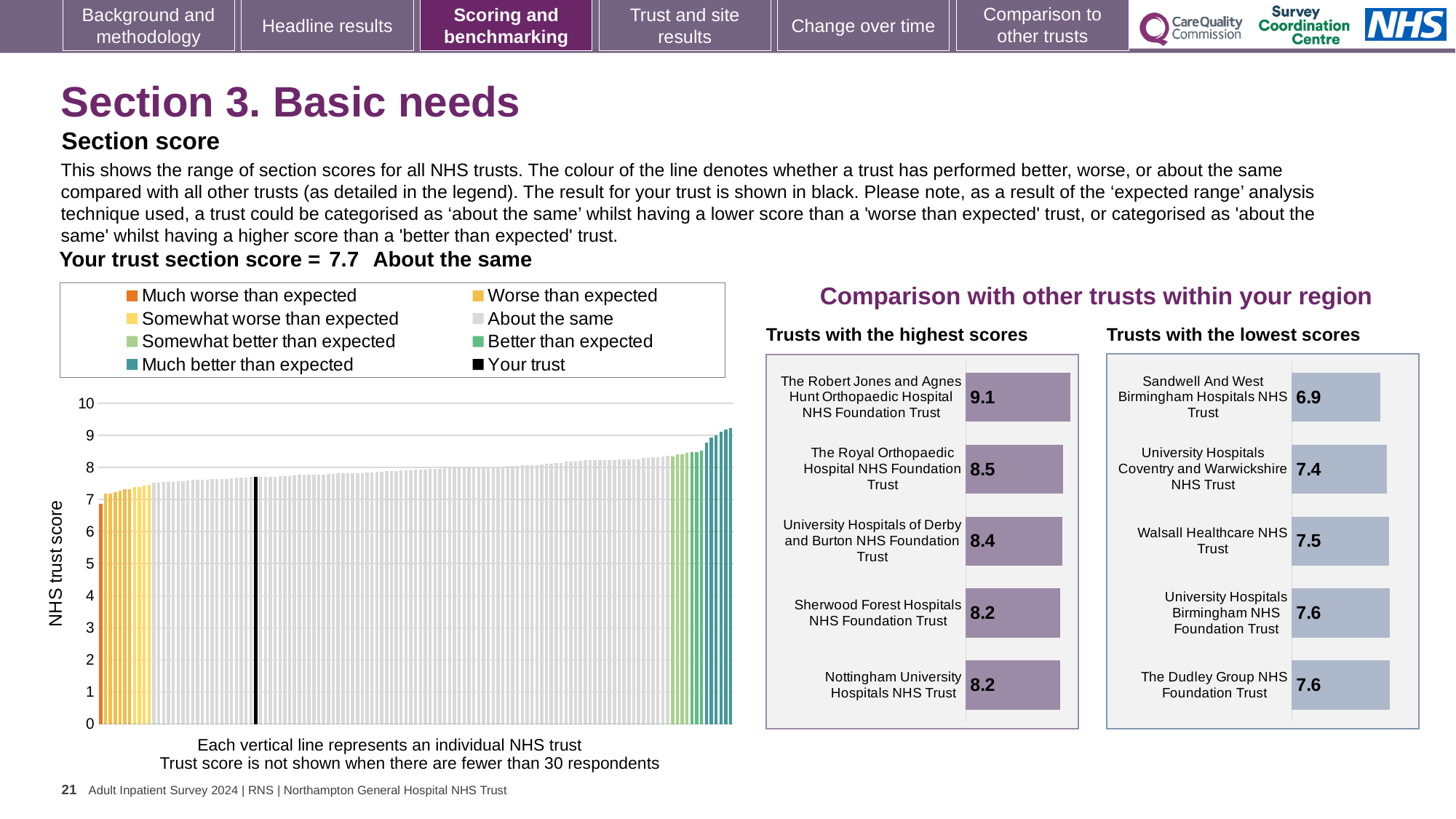
In the 'Trusts with the lowest scores' chart, which trust has the lowest score? Sandwell And West Birmingham Hospitals NHS Trust How many entries does the legend of the main chart on the left list? 8 In the 'Trusts with the lowest scores' chart, what is the score for Walsall Healthcare NHS Trust? 7.5 In the 'Trusts with the highest scores' chart, what is the score for The Robert Jones and Agnes Hunt Orthopaedic Hospital NHS Foundation Trust? 9.1 In the 'Trusts with the lowest scores' chart, what is the difference between the scores of The Dudley Group NHS Foundation Trust and Sandwell And West Birmingham Hospitals NHS Trust? 0.7 In the main chart on the left showing all NHS trusts, what is the section score for your trust (the black bar)? 7.7 What kind of chart is the main chart on the left showing all NHS trusts? Bar chart How many trusts are shown in the 'Trusts with the highest scores' chart? 5 In the 'Trusts with the highest scores' chart, which trust has the highest score? The Robert Jones and Agnes Hunt Orthopaedic Hospital NHS Foundation Trust In the 'Trusts with the highest scores' chart, what is the difference between the scores of The Robert Jones and Agnes Hunt Orthopaedic Hospital NHS Foundation Trust and The Royal Orthopaedic Hospital NHS Foundation Trust? 0.6 In the 'Trusts with the lowest scores' chart, which has the higher score: University Hospitals Coventry and Warwickshire NHS Trust or University Hospitals Birmingham NHS Foundation Trust? University Hospitals Birmingham NHS Foundation Trust In the main chart on the left, do the trust scores rise or fall from left to right? Rise